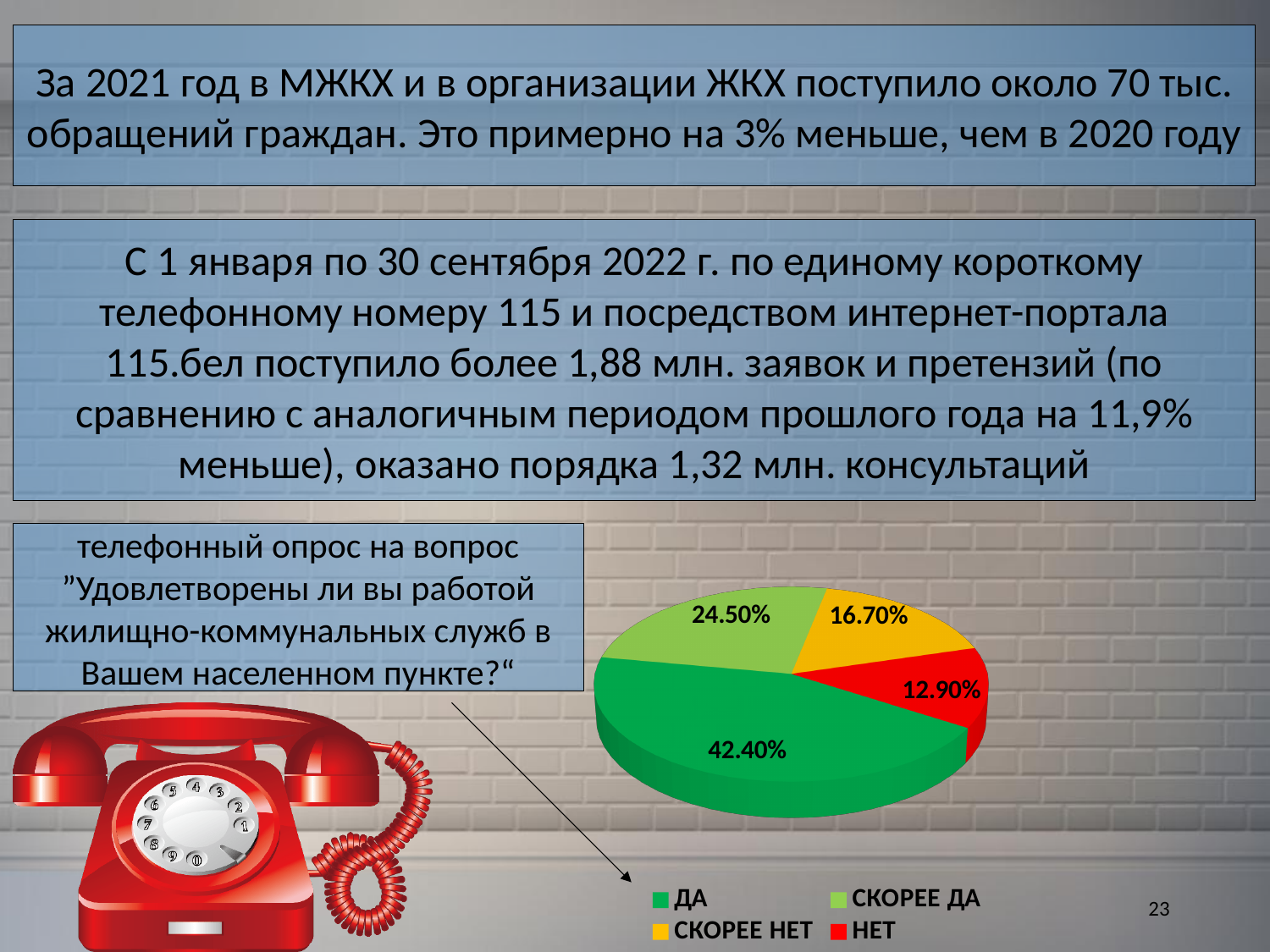
Which is larger in the pie chart, "СКОРЕЕ ДА" or "СКОРЕЕ НЕТ"? СКОРЕЕ ДА How many slices does the pie chart have? 4 What is the difference between the "ДА" and "НЕТ" slices in the pie chart? 29.50% What is the value shown for "СКОРЕЕ ДА" in the pie chart? 24.50% What is the value shown for "НЕТ" in the pie chart? 12.90% What colour is the "НЕТ" slice in the pie chart? red What kind of chart is shown on the slide? pie chart What is the value shown for "СКОРЕЕ НЕТ" in the pie chart? 16.70% How many entries does the legend of the pie chart list? 4 Which category has the largest slice in the pie chart? ДА What share of the pie chart does the "ДА" slice represent? 42.40% Which category has the smallest slice in the pie chart? НЕТ